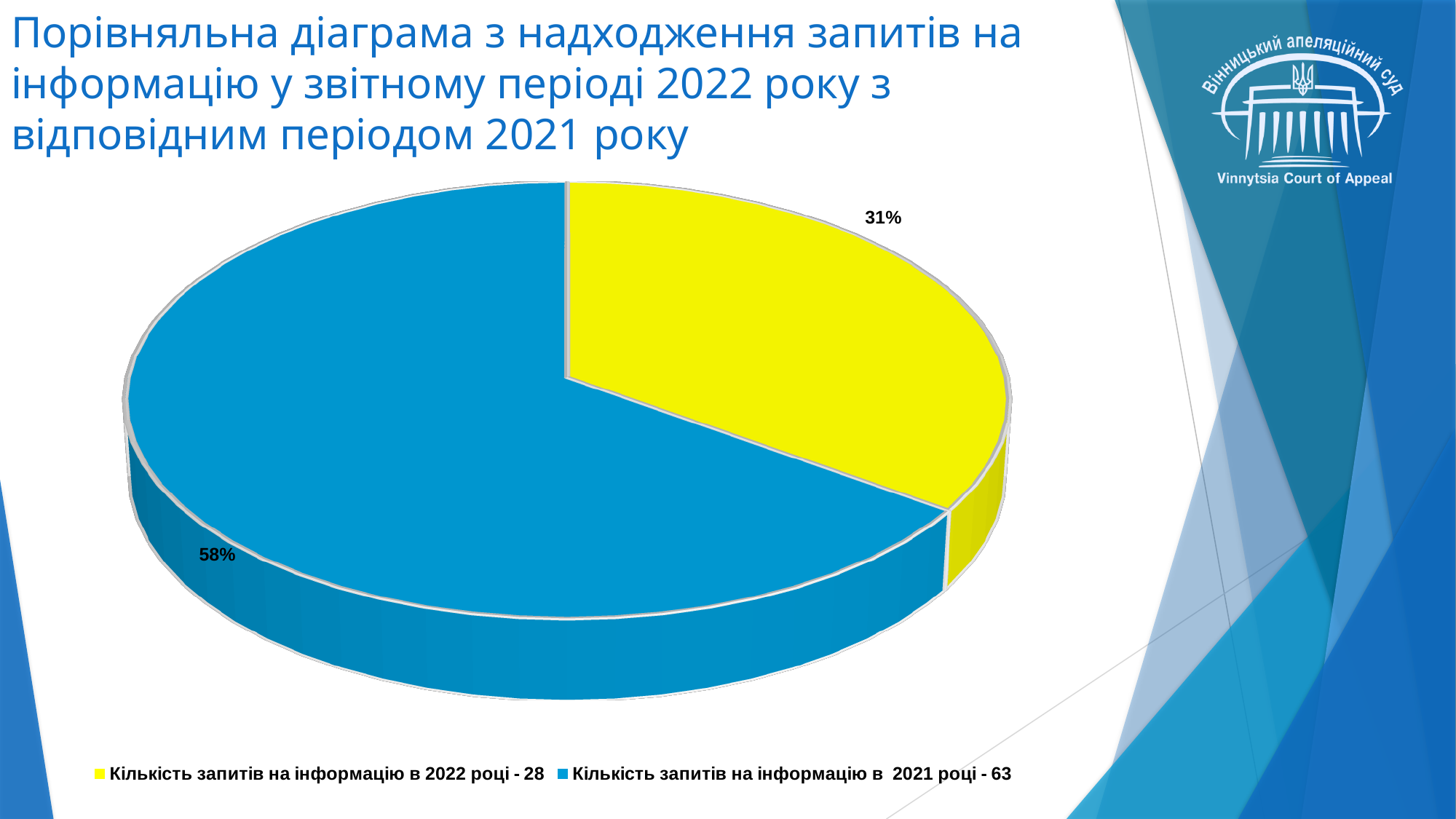
According to the legend, how many information requests were received in 2022? 28 Which slice of the pie is the largest? Кількість запитів на інформацію в 2021 році - 63 What kind of chart is shown on the slide? pie chart What is the difference in percentage points between the 2021 slice (58%) and the 2022 slice (31%)? 27 percentage points What percentage is shown for the slice 'Кількість запитів на інформацію в 2021 році - 63'? 58% What percentage is shown for the slice 'Кількість запитів на інформацію в 2022 році - 28'? 31% Which is larger: the share for 2022 requests or the share for 2021 requests? 2021 requests Which slice of the pie is the smallest? Кількість запитів на інформацію в 2022 році - 28 What colour is the slice representing requests in 2022? yellow How many entries does the legend list? 2 How many slices does the pie chart have? 2 According to the legend, how many information requests were received in 2021? 63